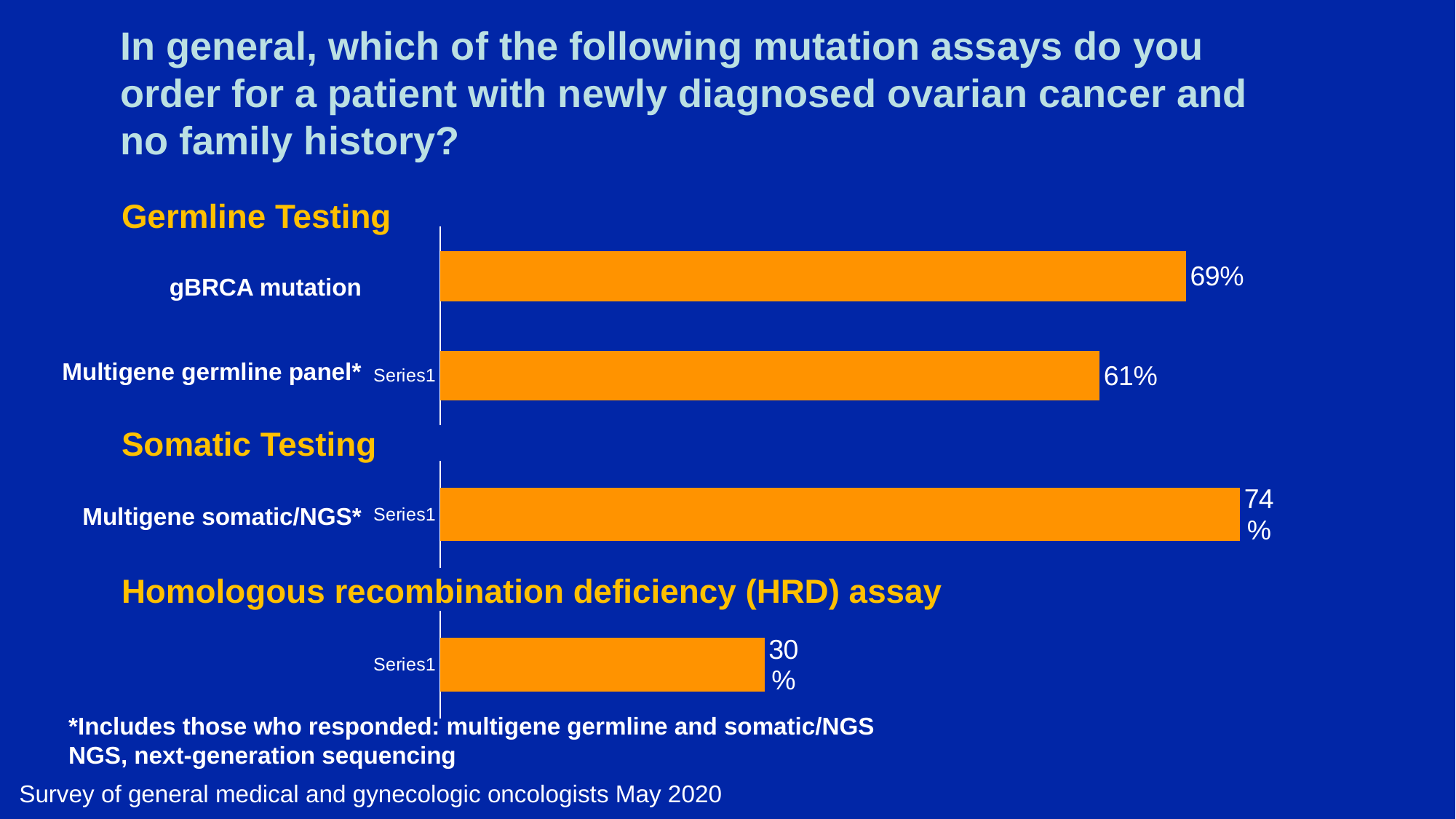
In the Germline Testing chart, what is the value for gBRCA mutation? 69% In the Homologous recombination deficiency (HRD) assay chart, what value is shown on the bar? 30% In the Germline Testing chart, which category has the higher value? gBRCA mutation Which is larger: the Multigene somatic/NGS* value in the Somatic Testing chart or the gBRCA mutation value in the Germline Testing chart? Multigene somatic/NGS* What is the difference between the Multigene somatic/NGS* value in the Somatic Testing chart and the value in the HRD assay chart? 44% What colour are the bars in the Somatic Testing chart? Orange What type of chart is used for the Germline Testing data? Bar chart How many bars are in the Germline Testing chart? 2 In the Germline Testing chart, which category has the lower value? Multigene germline panel* In the Germline Testing chart, what is the value for Multigene germline panel*? 61% In the Somatic Testing chart, what is the value for Multigene somatic/NGS*? 74% In the Germline Testing chart, what is the difference between the gBRCA mutation value and the Multigene germline panel* value? 8%